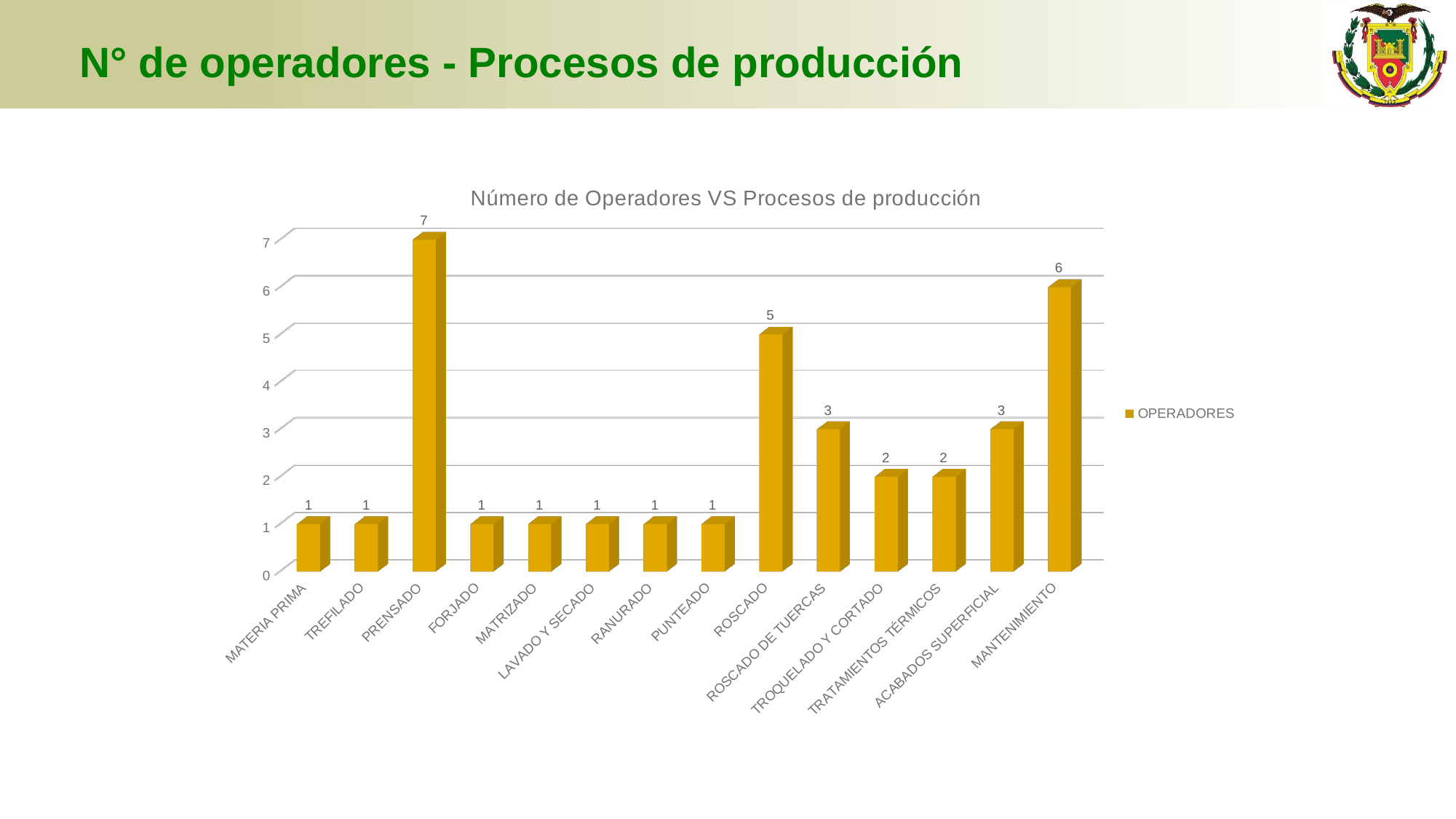
How many categories are shown on the x axis? 14 What is the value for TROQUELADO Y CORTADO? 2 What is the value for PRENSADO? 7 What kind of chart is shown? Bar chart Which is larger, the value for ROSCADO or the value for ACABADOS SUPERFICIAL? ROSCADO What is the title of the chart? Número de Operadores VS Procesos de producción Which category has the highest value? PRENSADO What is the difference between the values for PRENSADO and MANTENIMIENTO? 1 What is the value for ROSCADO? 5 What is the difference between the values for ROSCADO and ROSCADO DE TUERCAS? 2 What is the value for MANTENIMIENTO? 6 How many series does the legend list? 1